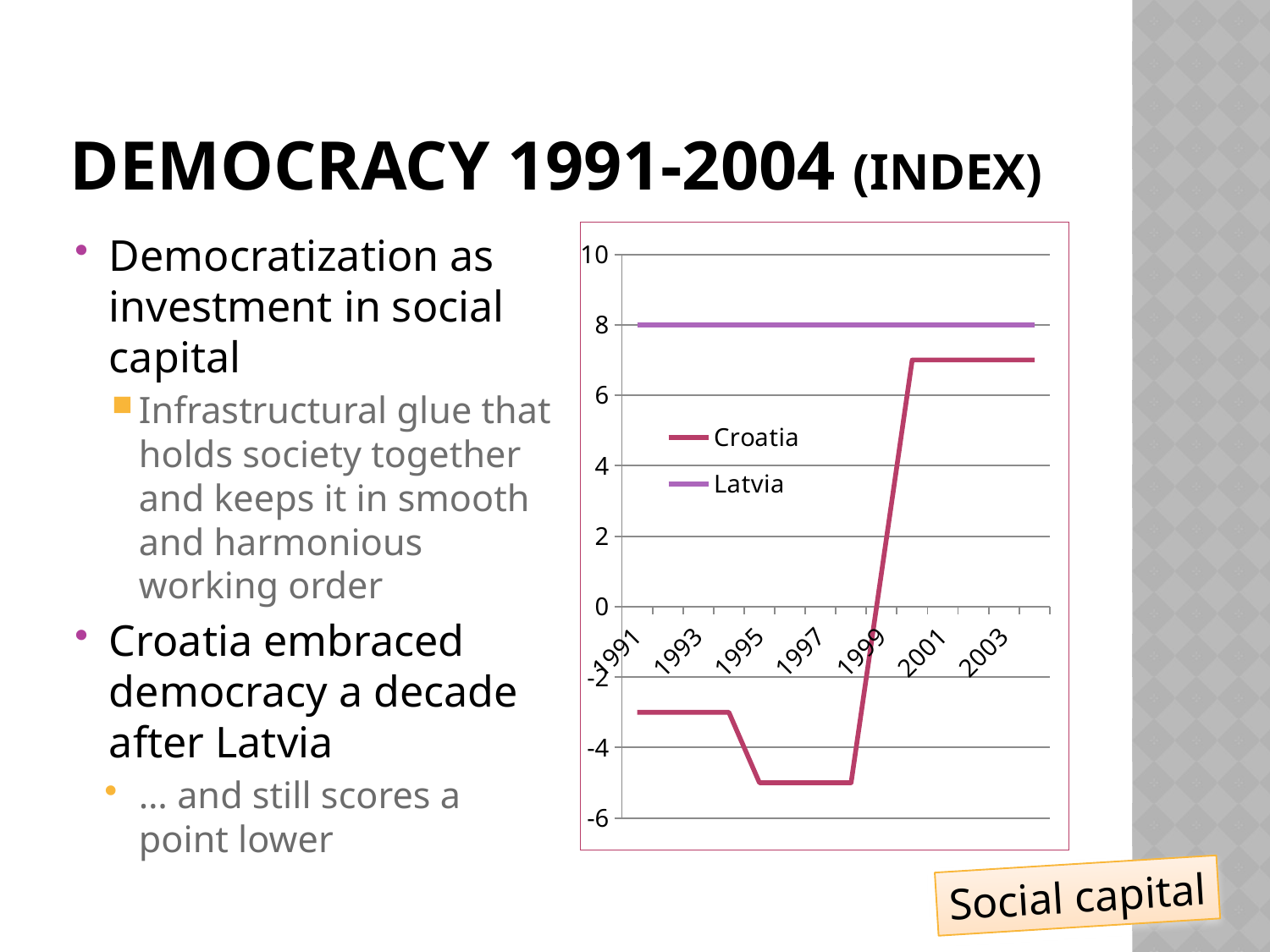
What is the value for Latvia in 2003? 8 How many series does the chart's legend list? 2 What is the value for Latvia in 1991? 8 Is the value for Croatia in 1997 greater or less than -4? less Is the value for Croatia in 1991 greater or less than 0? less Which series has the higher value in 1993, Croatia or Latvia? Latvia Is the value for Croatia in 2003 greater or less than 6? greater Which series has the higher value in 2003, Croatia or Latvia? Latvia Does the Croatia line rise or fall overall from 1991 to the end of the series? rises Which two series are listed in the chart's legend? Croatia and Latvia How many year labels are shown on the x axis? 7 What kind of chart is shown on the slide? line chart